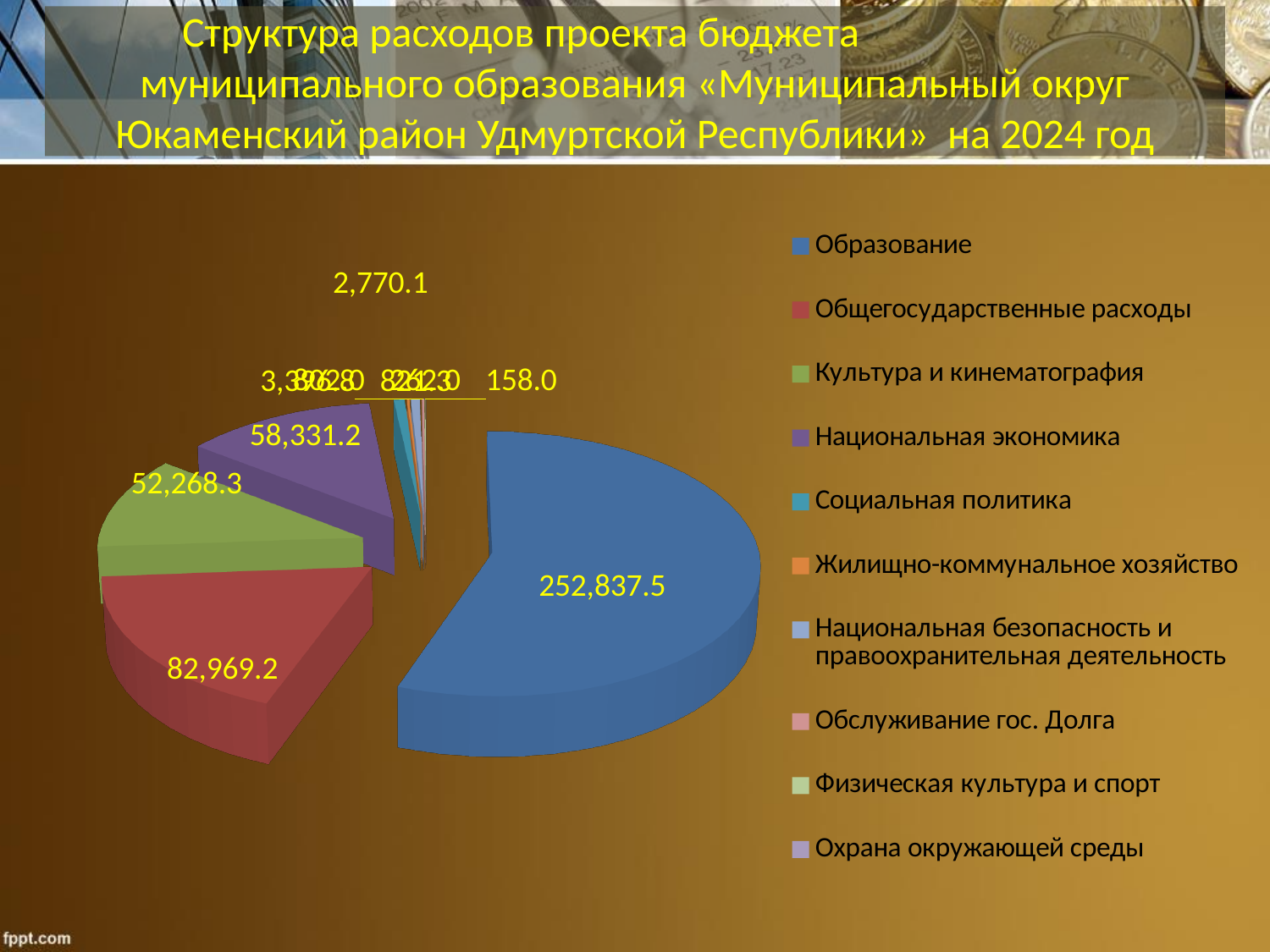
What type of chart is shown on the slide? pie chart What is the value shown for Культура и кинематография? 52,268.3 What is the value shown for Национальная экономика? 58,331.2 What is the value shown for Образование in the pie chart? 252,837.5 What is the difference between the values for Общегосударственные расходы and Культура и кинематография? 30,700.9 What colour is the slice for Образование in the pie chart? blue How many categories does the legend of the pie chart list? 10 Which is larger: Национальная экономика or Культура и кинематография? Национальная экономика By how much does the value for Образование exceed the value for Общегосударственные расходы? 169,868.3 Which category has the largest slice in the pie chart? Образование What is the value shown for Общегосударственные расходы? 82,969.2 What is the difference between the values for Национальная экономика and Культура и кинематография? 6,062.9